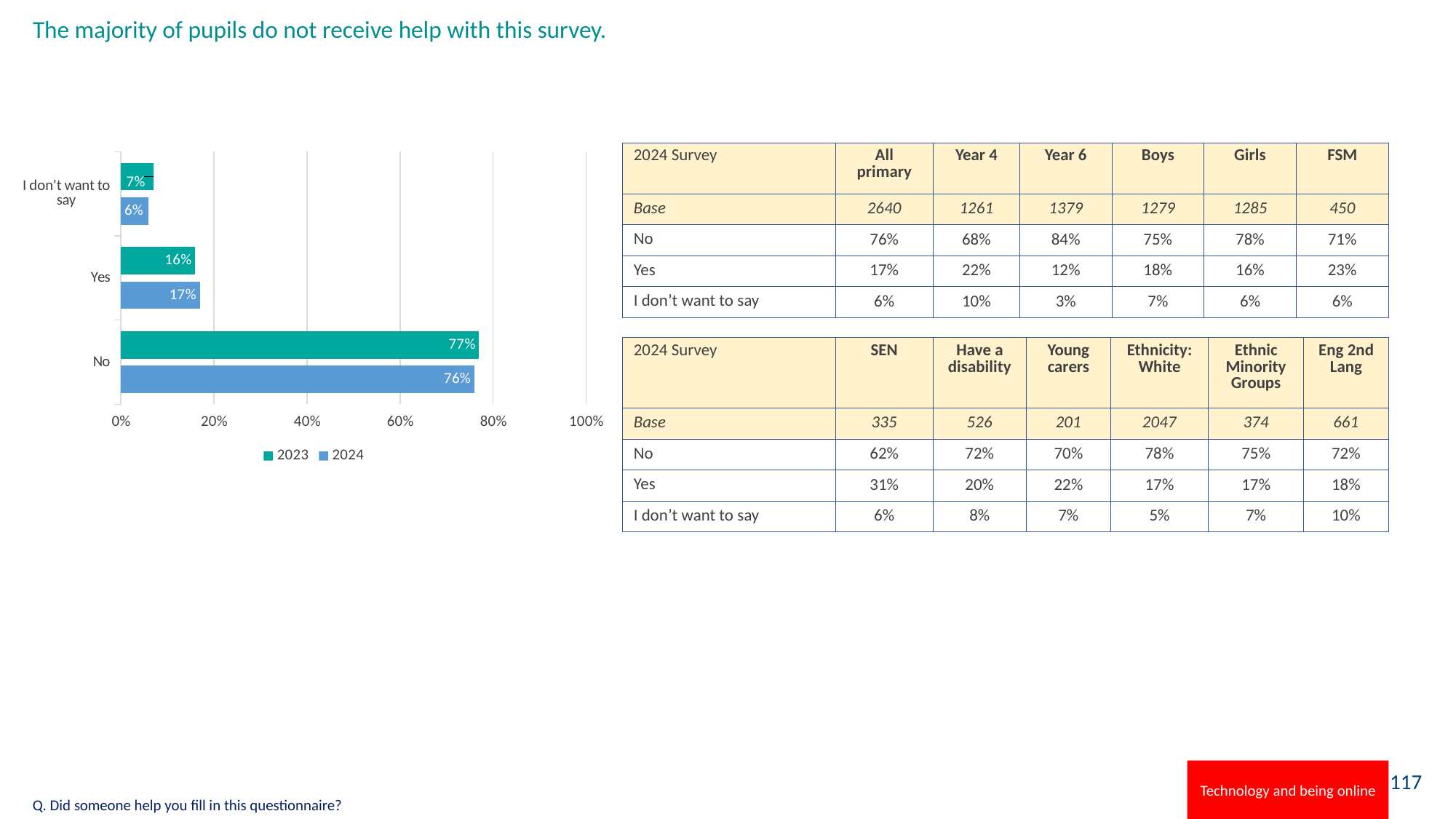
What is the 2023 value for "No"? 77% What is the 2024 value for "Yes"? 17% Which is larger for "Yes": the 2023 value or the 2024 value? 2024 What is the 2023 value for "I don't want to say"? 7% Which category has the highest value in the 2024 series? No What is the 2024 value for "I don't want to say"? 6% How many series does the legend list? 2 Is the 2024 value for "No" greater or less than 60%? greater What kind of chart is shown on the slide? Bar chart What is the difference between the 2023 and 2024 values for "No"? 1% Which category has the lowest value in the 2023 series? I don't want to say How many categories are shown on the chart? 3